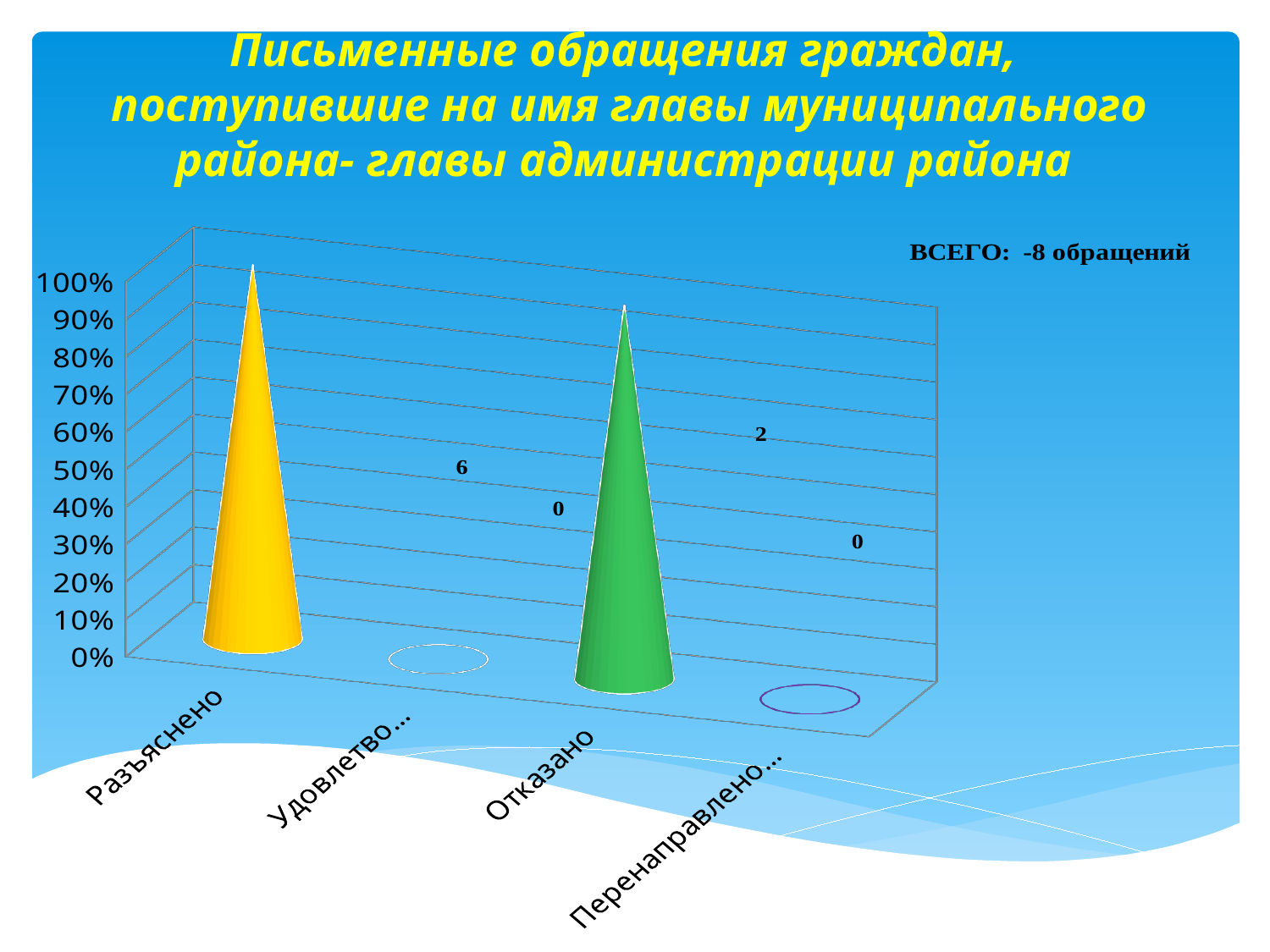
Which category has the highest value in the chart? Разъяснено What colour is the cone for the category Отказано? green How many categories are shown on the x axis of the chart? 4 What colour is the cone for the category Разъяснено? yellow What kind of chart is shown on the slide? bar chart Which is larger, the value for Разъяснено or the value for Отказано? Разъяснено What value is shown for the category Отказано? 2 Is the value for Разъяснено greater or less than 50% on the vertical axis? greater What value is shown for the category Разъяснено? 6 What is the difference between the values for Разъяснено and Отказано? 4 According to the text on the slide, what is the total number of обращений (appeals)? 8 обращений How many data labels in the chart show a value of 0? 2